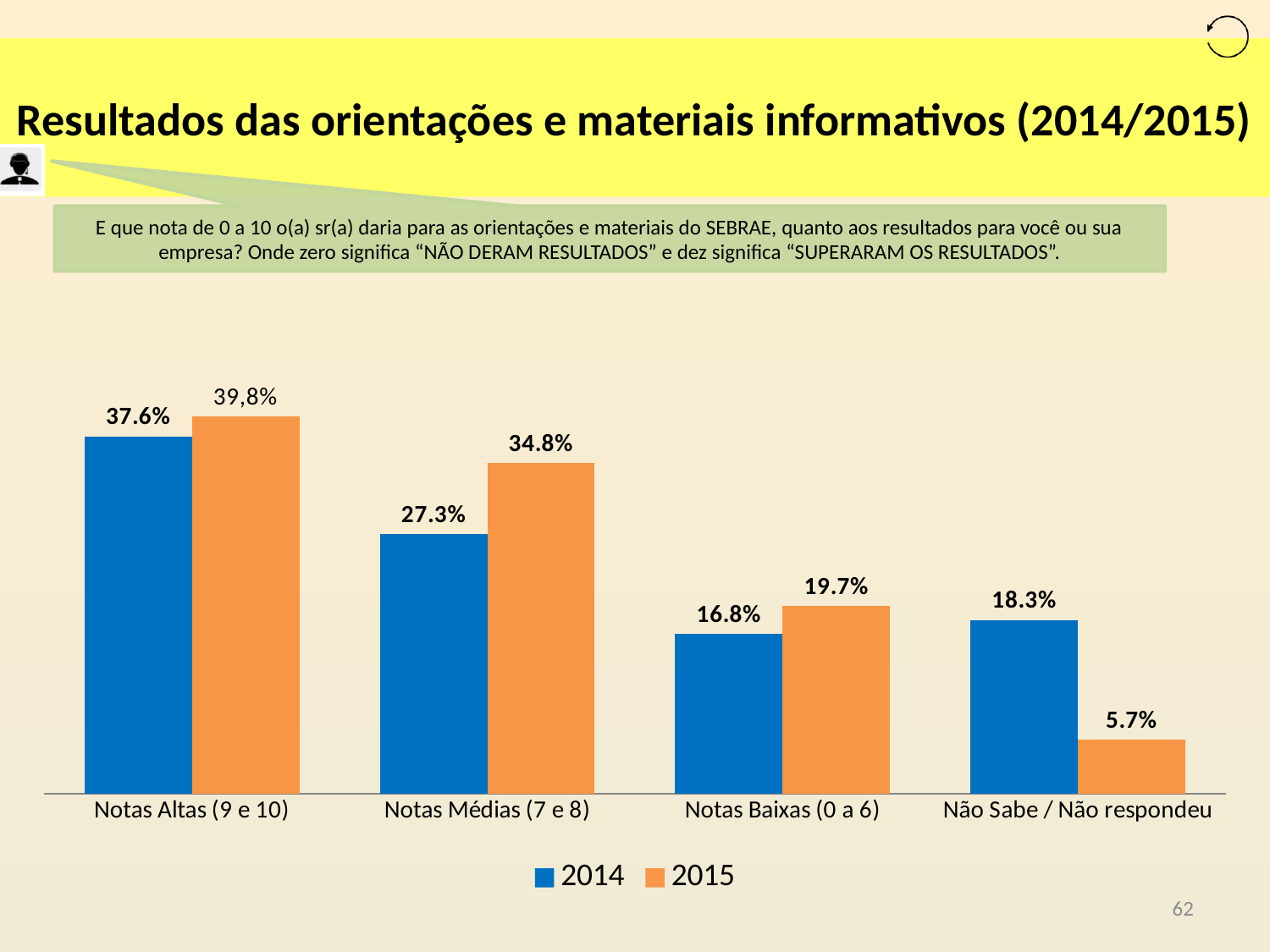
What is the value for 2014 in the Notas Altas (9 e 10) category? 37.6% How many categories are shown on the x axis? 4 What is the difference between the 2014 and 2015 values for Não Sabe / Não respondeu? 12.6% What kind of chart is shown on the slide? Bar chart Which is larger in the Notas Baixas (0 a 6) category, the 2014 value or the 2015 value? 2015 Which category has the highest value for 2014? Notas Altas (9 e 10) What is the value for 2015 in the Notas Altas (9 e 10) category? 39,8% What is the value for 2015 in the Notas Médias (7 e 8) category? 34.8% How many series does the legend list? 2 Which category has the lowest value for 2015? Não Sabe / Não respondeu What is the value for 2014 in the Não Sabe / Não respondeu category? 18.3% What is the difference between the 2015 and 2014 values for Notas Médias (7 e 8)? 7.5%